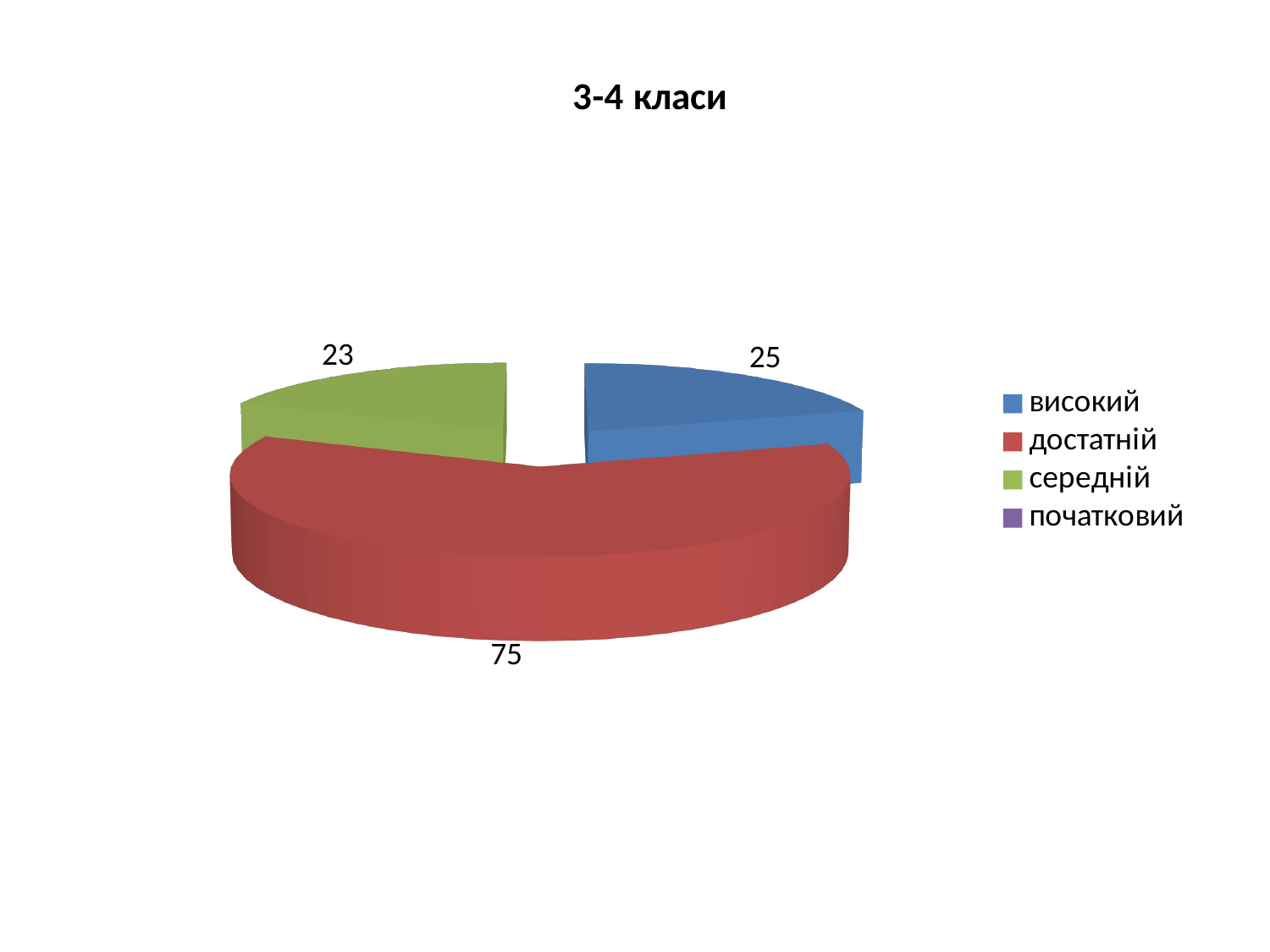
Which of the labelled slices has the smallest value? середній What is the difference between the values for достатній and високий? 50 What is the difference between the values for високий and середній? 2 How many entries does the legend list? 4 Which is larger, the value for високий or the value for середній? високий Which category has the largest slice? достатній What is the value for середній? 23 What colour is the slice for достатній? red What is the value for високий? 25 What kind of chart is shown on the slide? pie chart What is the title of the chart? 3-4 класи What is the value for достатній? 75